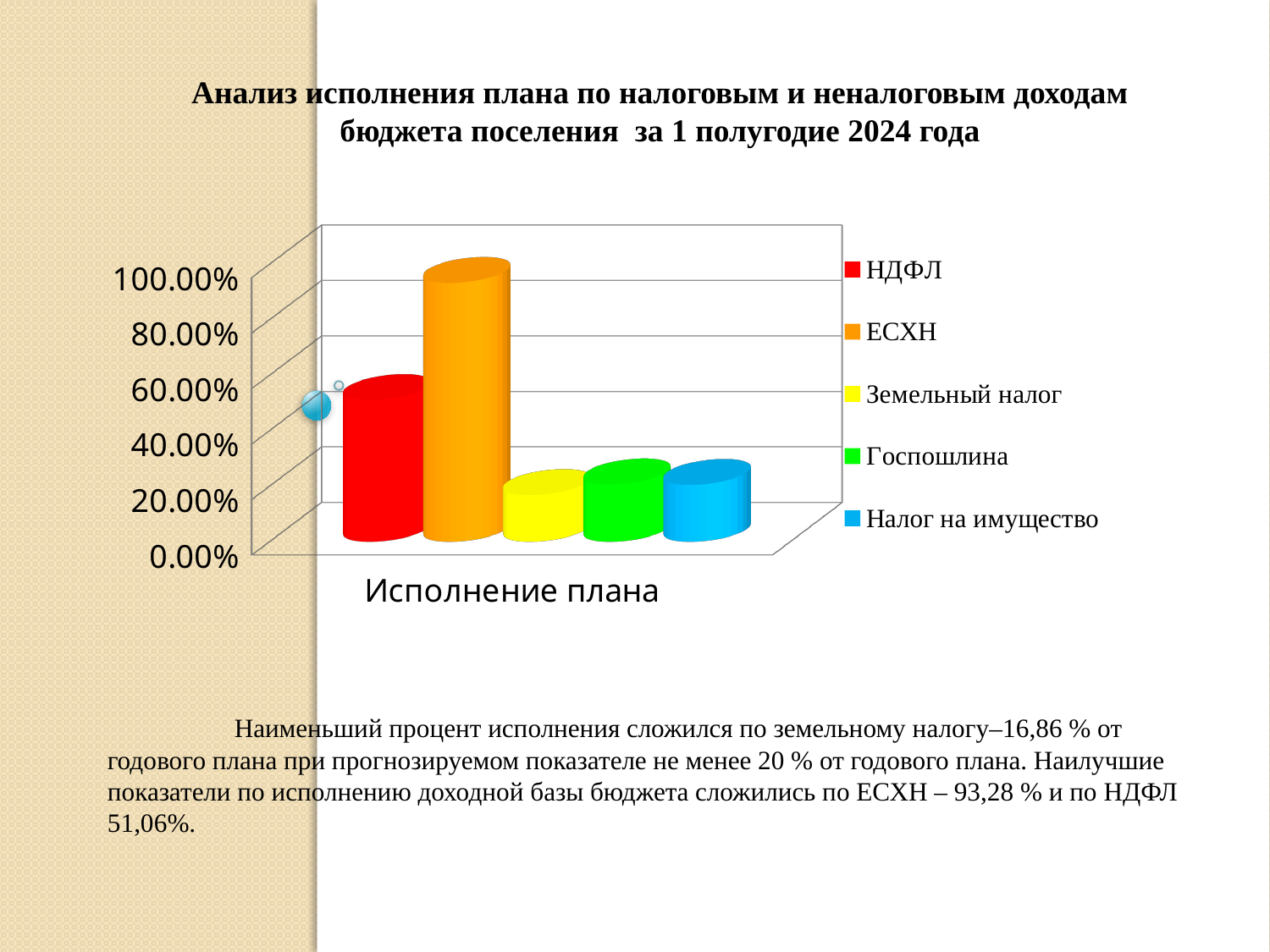
How many categories are shown on the x axis of the chart? 1 Is the value for ЕСХН greater or less than 80.00%? greater How many series does the chart legend list? 5 Which series has the lowest bar in the chart? Земельный налог Which is larger, the value for Земельный налог or the value for Госпошлина? Госпошлина Is the value for НДФЛ greater or less than 40.00%? greater Which is larger, the value for НДФЛ or the value for Госпошлина? НДФЛ What is the category label shown on the x axis of the chart? Исполнение плана Which series has the highest bar in the chart? ЕСХН Is the value for Земельный налог greater or less than 20.00%? less What kind of chart is shown on the slide? bar chart